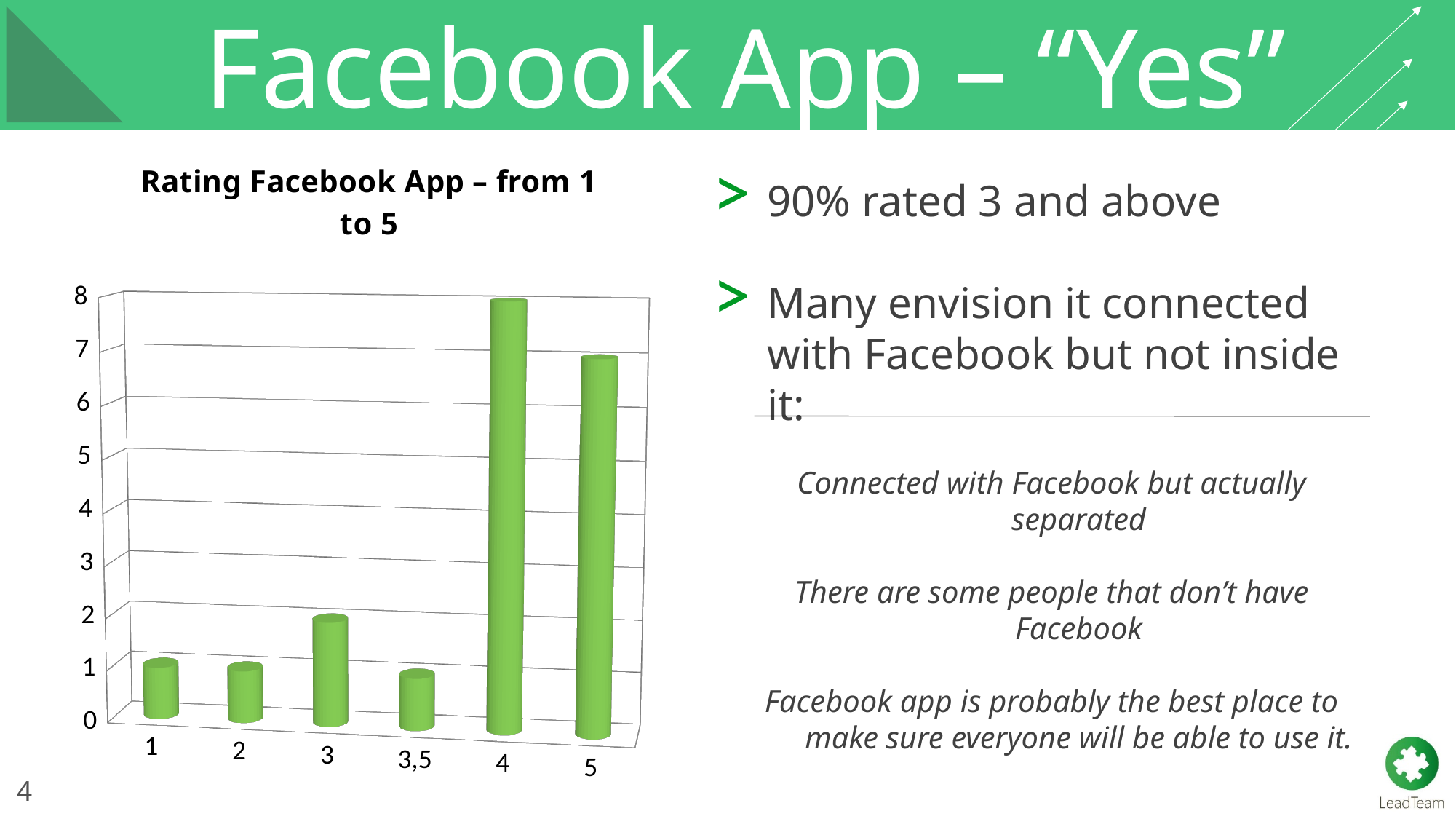
Is the value for category 3 greater or less than 4? less Which category has the highest bar in the chart? 4 Which has a larger value, category 3 or category 1? 3 Is the value for category 4 greater or less than 6? greater Is the value for category 3,5 greater or less than 2? less What type of chart is shown on the slide? bar chart What is the title of the chart? Rating Facebook App – from 1 to 5 How many categories are shown on the x axis of the chart? 6 Which has a larger value, category 4 or category 5? 4 What is the highest value shown on the vertical axis of the chart? 8